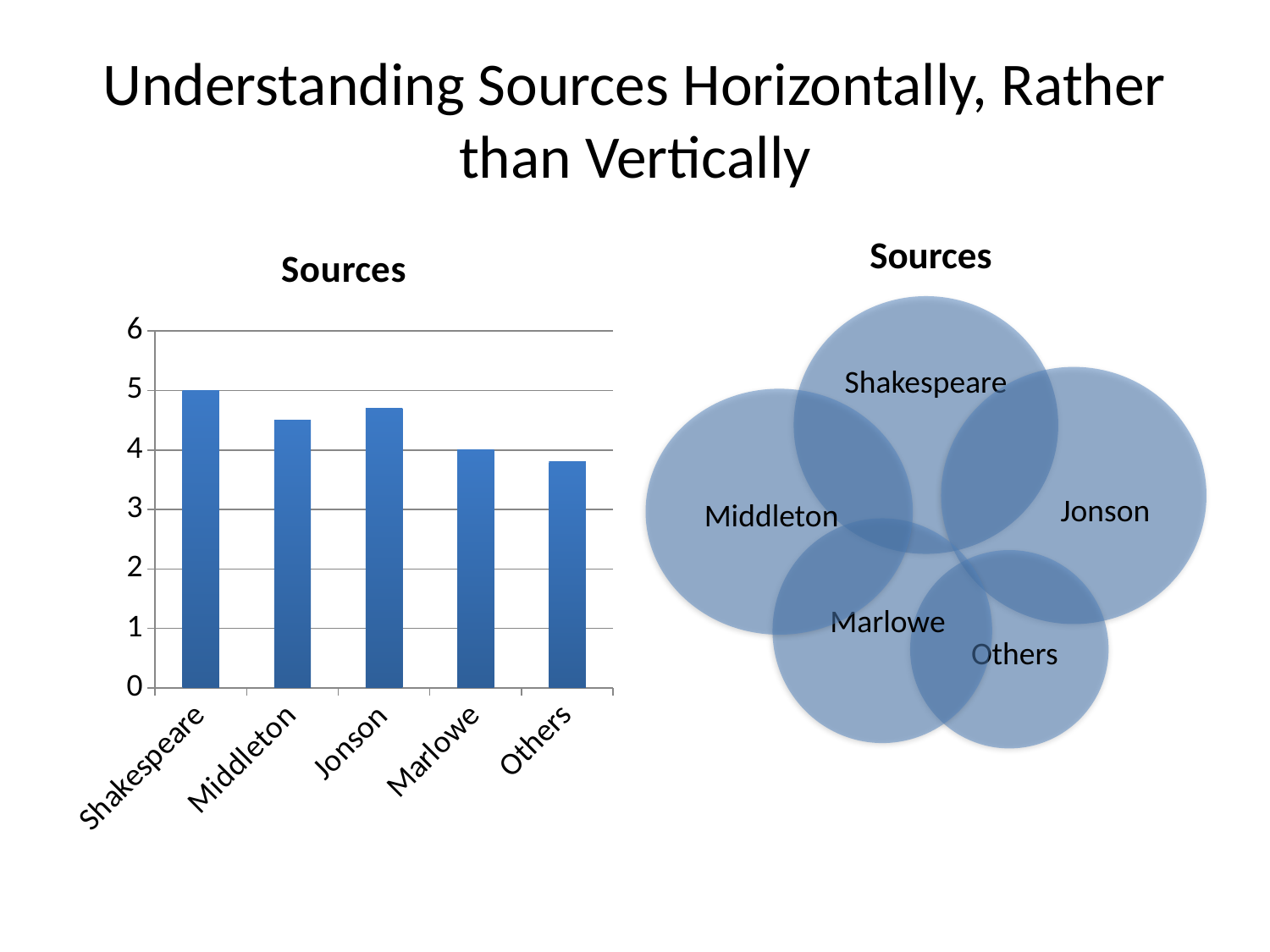
In the bar chart titled "Sources", what is the value for Shakespeare? 5 In the bar chart titled "Sources", which is larger, the value for Shakespeare or the value for Middleton? Shakespeare In the bar chart titled "Sources", what is the value for Marlowe? 4 What kind of chart is the left-hand chart titled "Sources"? bar chart In the bar chart titled "Sources", is the value for Others greater or less than 4? less In the bar chart titled "Sources", which category has the highest value? Shakespeare In the bar chart titled "Sources", is the value for Jonson greater or less than 5? less In the bar chart titled "Sources", how many categories are shown on the x axis? 5 In the bar chart titled "Sources", which category has the lowest value? Others In the bar chart titled "Sources", is the value for Middleton greater or less than 4? greater In the bar chart titled "Sources", what is the difference between the value for Shakespeare and the value for Marlowe? 1 In the right-hand diagram titled "Sources", which label appears in the topmost circle? Shakespeare